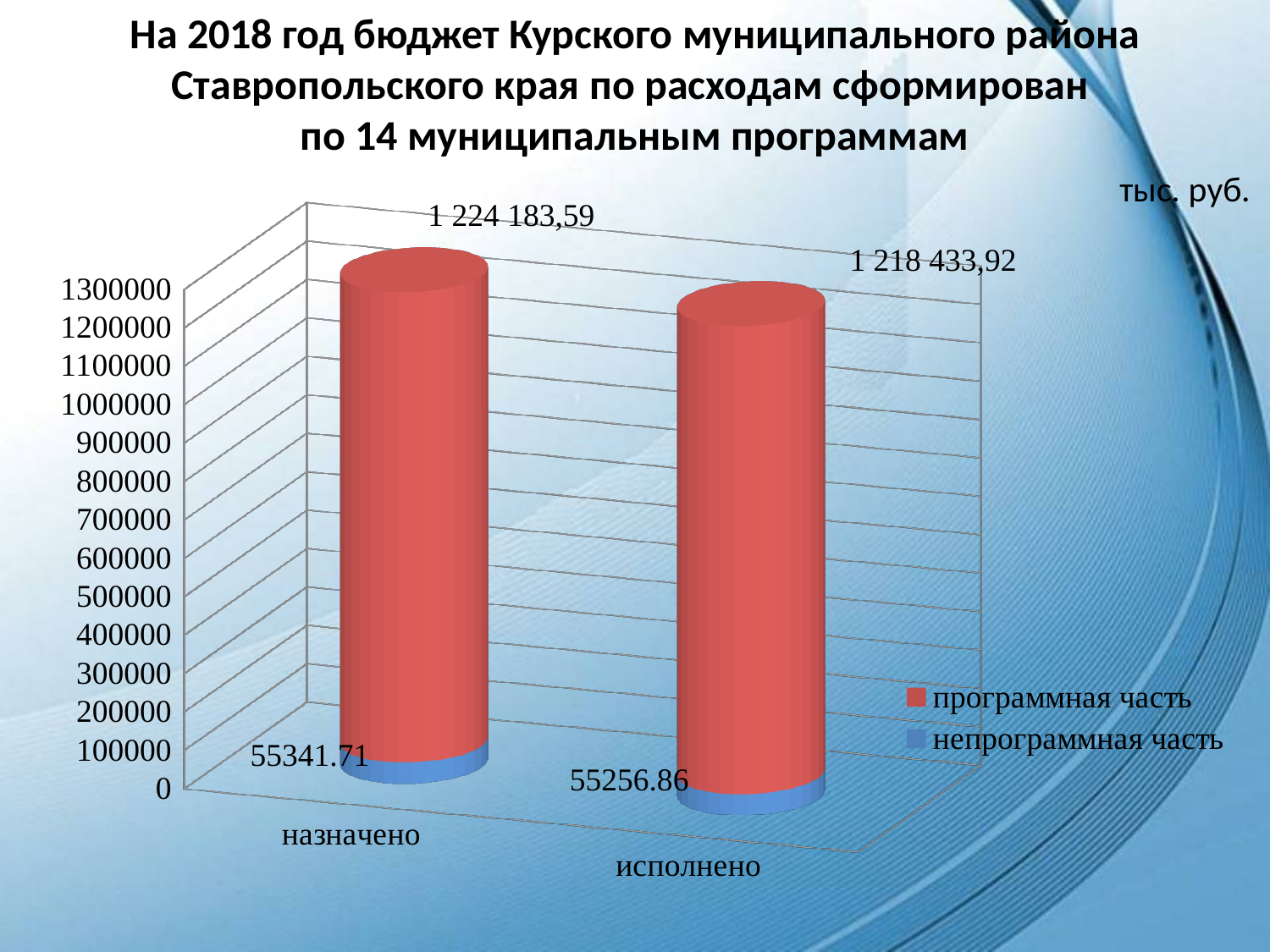
What is the difference between the программная часть values for назначено and исполнено? 5 749,67 What is the difference between the непрограммная часть values for назначено and исполнено? 84.85 How many categories are shown on the x axis of the chart? 2 What value is shown for the непрограммная часть series in the назначено category? 55341.71 How many series does the chart legend list? 2 What kind of chart is shown on the slide? Stacked bar chart What value is shown for the программная часть series in the назначено category? 1 224 183,59 Which category has the lower value for the непрограммная часть series? исполнено What value is shown for the непрограммная часть series in the исполнено category? 55256.86 What unit is indicated for the values in the chart? тыс. руб. Which category has the higher value for the программная часть series? назначено What value is shown for the программная часть series in the исполнено category? 1 218 433,92